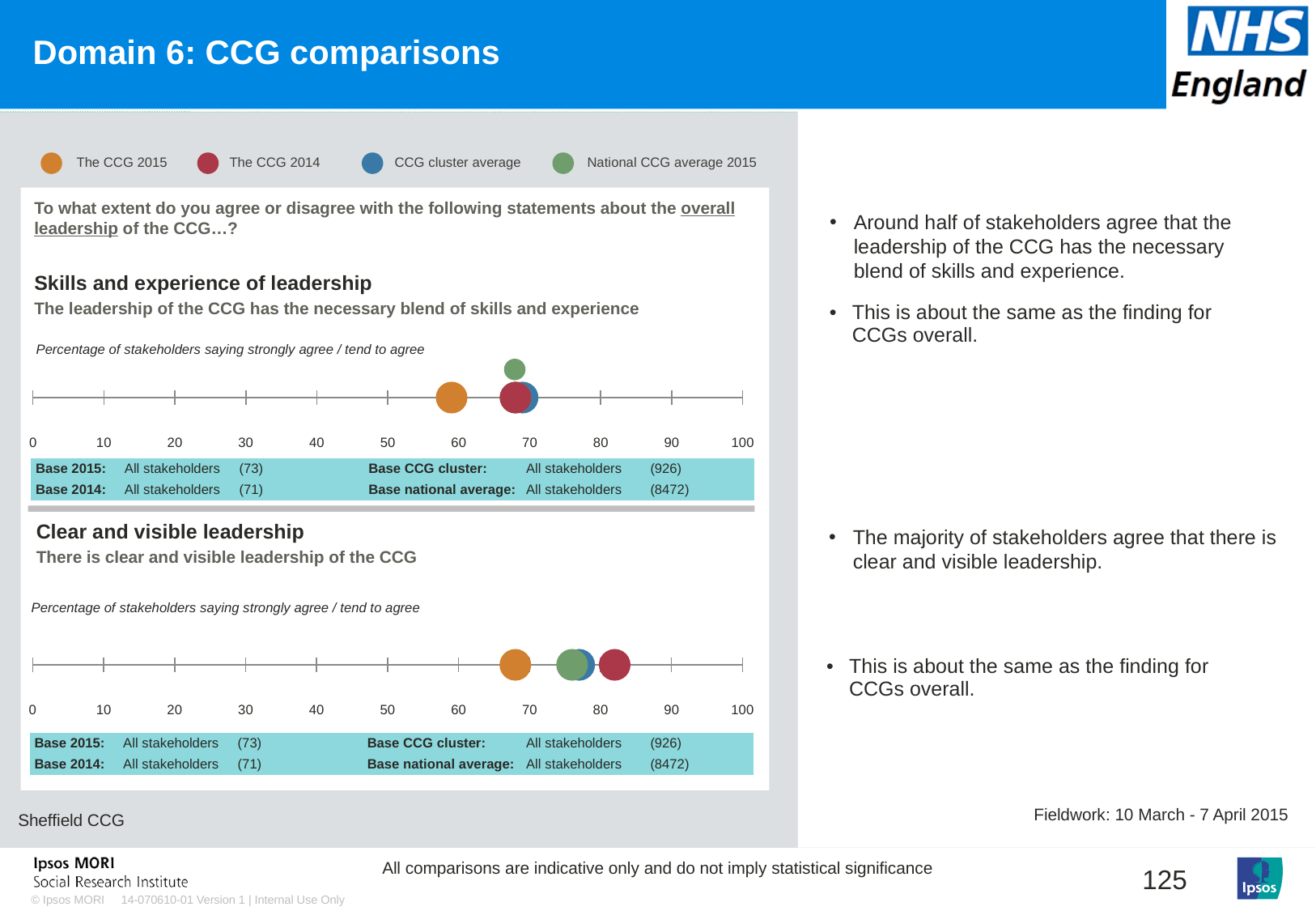
In the 'Clear and visible leadership' chart, is the value for National CCG average 2015 greater or less than 80? less In the 'Skills and experience of leadership' chart, is the value for The CCG 2015 greater or less than 50? greater What kind of chart is used on this slide? Dot plot How many series does the legend list? 4 In the 'Clear and visible leadership' chart, which series has the highest value? The CCG 2014 In the 'Skills and experience of leadership' chart, which series has the lowest value? The CCG 2015 What is the maximum value shown on the x axis of the charts? 100 In the 'Skills and experience of leadership' chart, which is larger: The CCG 2015 or The CCG 2014? The CCG 2014 In the 'Clear and visible leadership' chart, which series has the lowest value? The CCG 2015 In the 'Clear and visible leadership' chart, is the value for The CCG 2015 greater or less than 60? greater What colour represents The CCG 2015 in the legend? Orange